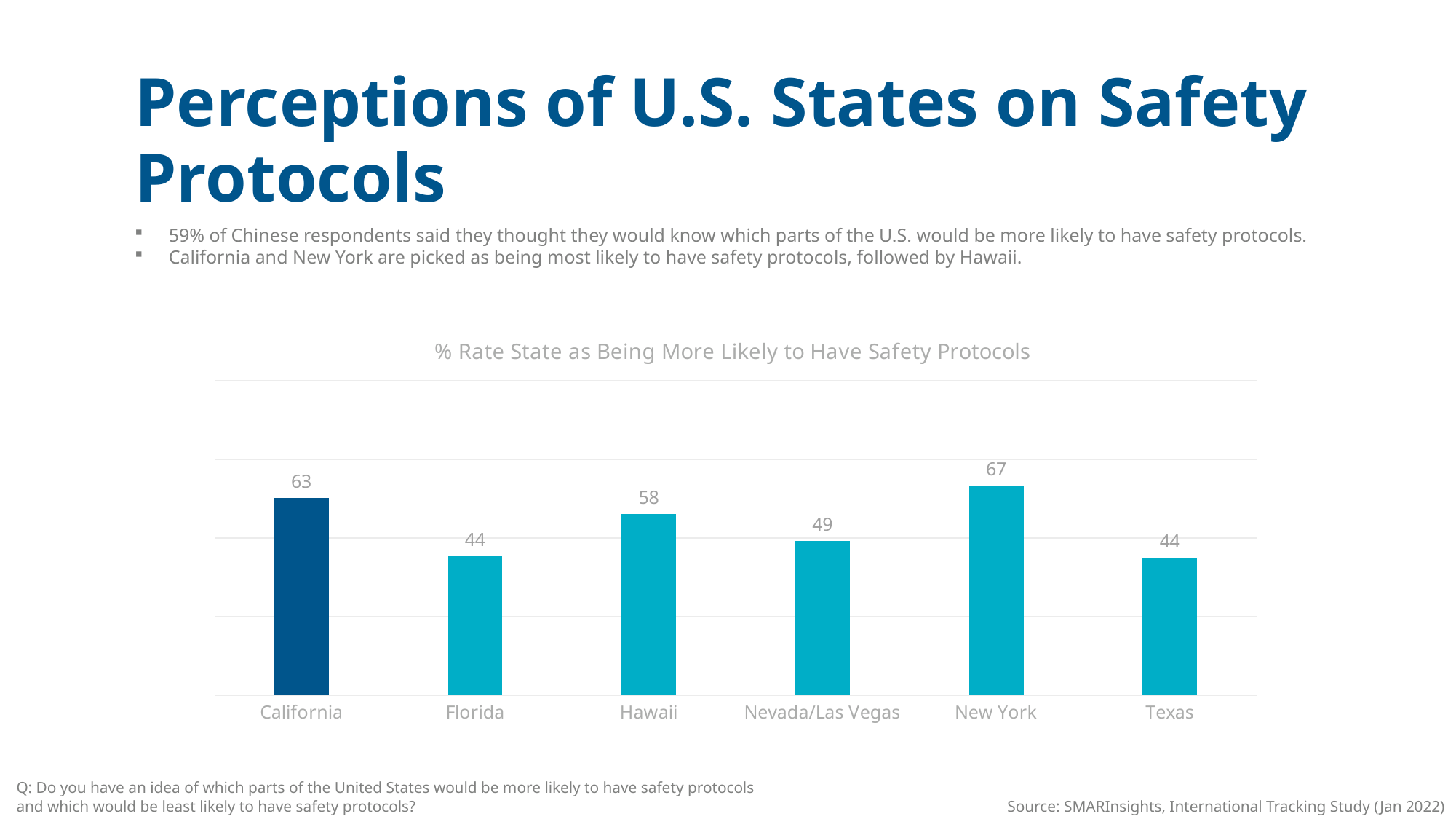
What is the value for Nevada/Las Vegas? 49 What kind of chart is shown on the slide? Bar chart What is the title of the chart? % Rate State as Being More Likely to Have Safety Protocols How many states are shown on the chart? 6 Which is larger, the value for California or the value for Texas? California What is the value for Hawaii? 58 Which is larger, the value for Hawaii or the value for Nevada/Las Vegas? Hawaii Which bar is shown in a darker blue colour than the others? California Which state has the highest value? New York What is the difference between the values for New York and California? 4 What is the value for California? 63 What is the difference between the values for Hawaii and Florida? 14